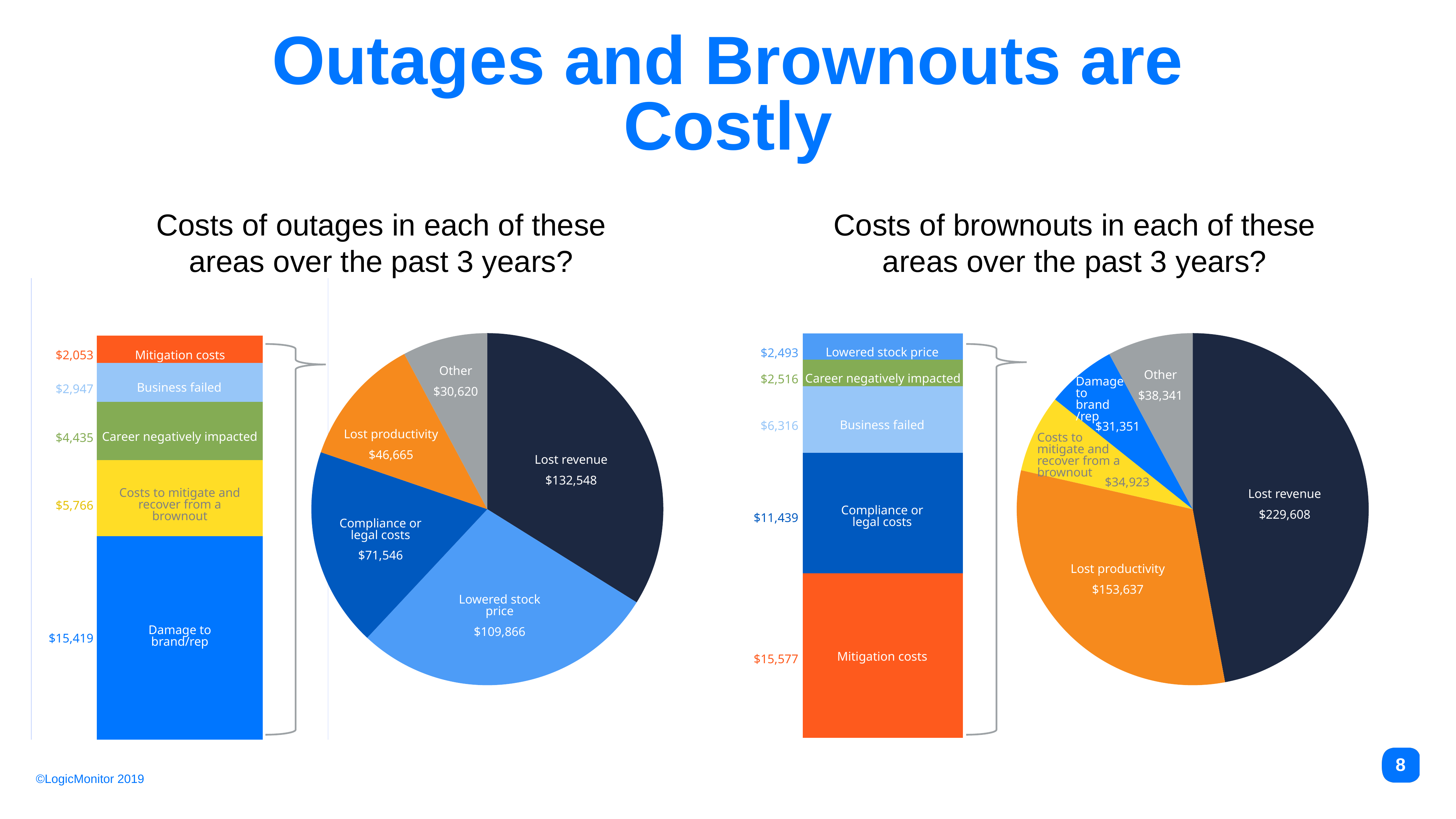
What is the title of the chart on the right side of the slide? Costs of brownouts in each of these areas over the past 3 years? In the 'Costs of outages' chart, what is the total of the stacked bar? $30,620 In the 'Costs of brownouts' chart, what is the value of the Lost productivity slice? $153,637 In the 'Costs of brownouts' chart, what is the total of the stacked bar? $38,341 In the 'Costs of brownouts' chart, how many slices does the pie have? 5 In the 'Costs of brownouts' chart, which segment of the stacked bar is the smallest? Lowered stock price In the 'Costs of outages' chart, what is the difference between Lost revenue and Lowered stock price? $22,682 In the 'Costs of outages' chart, what is the value of the Lost revenue slice? $132,548 In the 'Costs of outages' chart, which pie slice is the largest? Lost revenue In the 'Costs of outages' chart, how many segments make up the stacked bar? 5 In the 'Costs of brownouts' chart, which is larger: Mitigation costs or Compliance or legal costs? Mitigation costs In the 'Costs of outages' chart, what is the value of the Damage to brand/rep segment in the stacked bar? $15,419